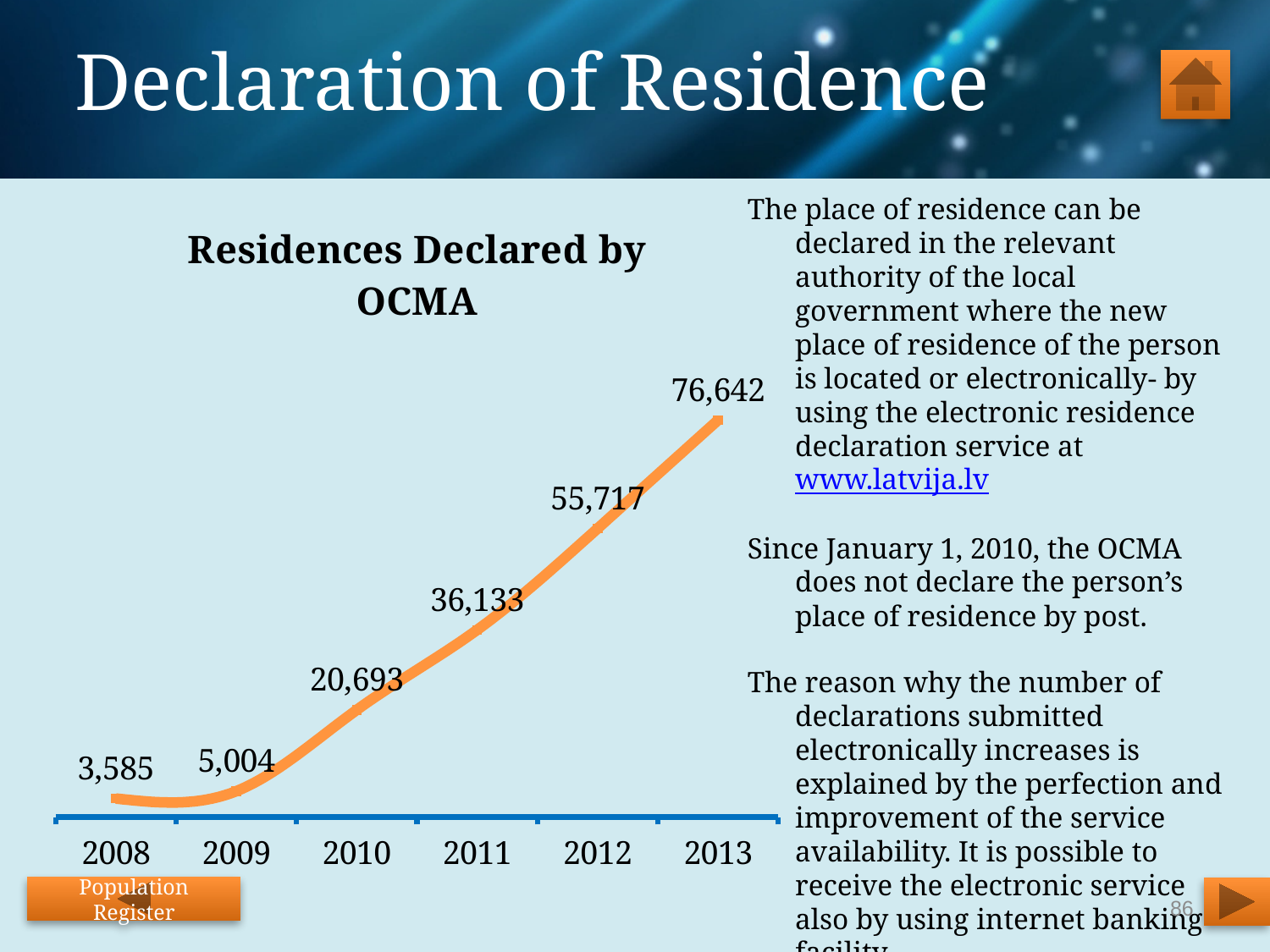
What kind of chart is the Residences Declared by OCMA chart? line chart What is the value for 2008 in the Residences Declared by OCMA chart? 3,585 Do the values in the Residences Declared by OCMA chart rise or fall from 2008 to 2013? rise What is the difference between the values for 2013 and 2012 in the Residences Declared by OCMA chart? 20,925 What is the value for 2011 in the Residences Declared by OCMA chart? 36,133 Which year has the highest value in the Residences Declared by OCMA chart? 2013 What is the value for 2013 in the Residences Declared by OCMA chart? 76,642 How many years are plotted in the Residences Declared by OCMA chart? 6 Which is larger in the Residences Declared by OCMA chart, the value for 2010 or the value for 2011? 2011 What is the title of the chart on the slide? Residences Declared by OCMA What is the difference between the values for 2009 and 2008 in the Residences Declared by OCMA chart? 1,419 Which year has the lowest value in the Residences Declared by OCMA chart? 2008